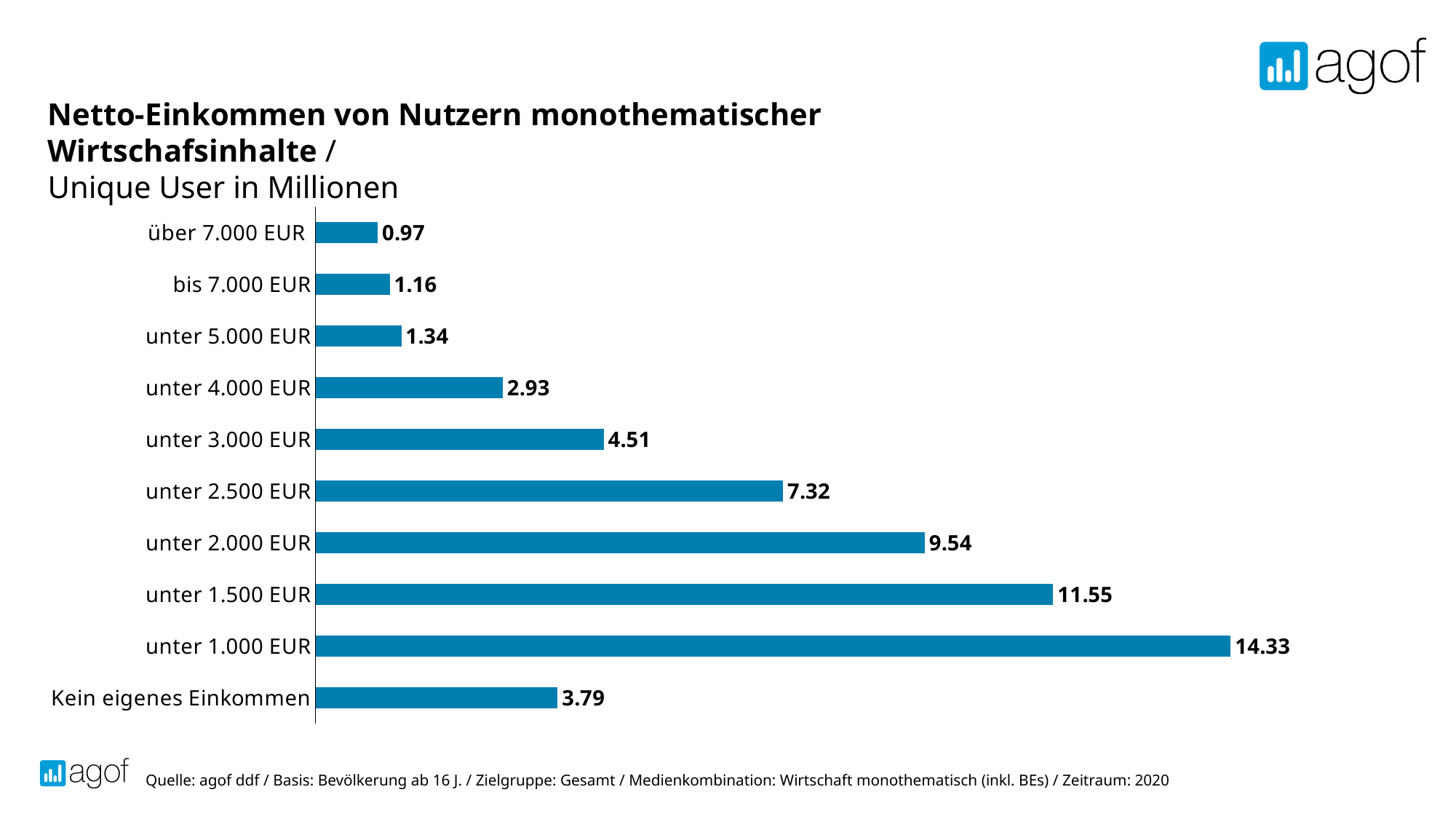
What is the value for "Kein eigenes Einkommen"? 3.79 What is the value for "unter 1.000 EUR"? 14.33 Which category has the lowest value? über 7.000 EUR What is the value for "unter 4.000 EUR"? 2.93 What is the difference between the values for "bis 7.000 EUR" and "über 7.000 EUR"? 0.19 Which category has the highest value? unter 1.000 EUR What kind of chart is shown on the slide? Bar chart In what unit are the values in the chart given, according to the subtitle? Unique User in Millionen What is the value for "unter 2.500 EUR"? 7.32 What is the difference between the values for "unter 1.500 EUR" and "unter 2.000 EUR"? 2.01 How many categories are shown in the chart? 10 Which is larger, the value for "unter 3.000 EUR" or the value for "Kein eigenes Einkommen"? unter 3.000 EUR